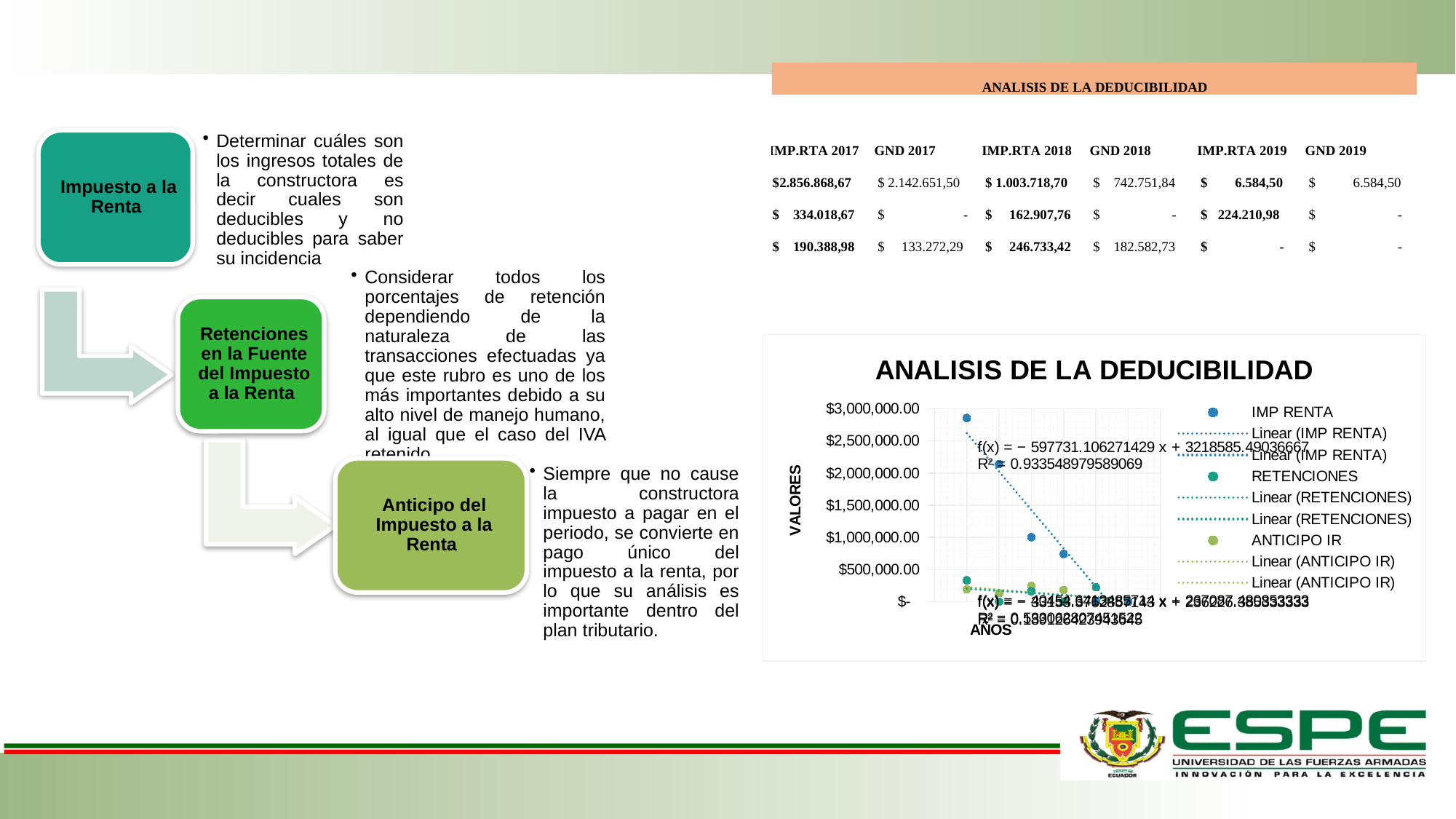
What is the title of the chart? ANALISIS DE LA DEDUCIBILIDAD What is the label of the vertical axis of the chart? VALORES Are all the RETENCIONES points greater or less than $500,000.00? less What kind of chart is shown on the slide? scatter chart Is the highest IMP RENTA point greater or less than $2,500,000.00? greater What R² value is shown for the IMP RENTA linear trendline? 0.933548979589069 How many data series (excluding the linear trendlines) are plotted in the chart? 3 Which series contains the highest plotted point in the chart? IMP RENTA How many entries does the chart legend list? 9 Do the IMP RENTA values rise or fall along the x axis? fall